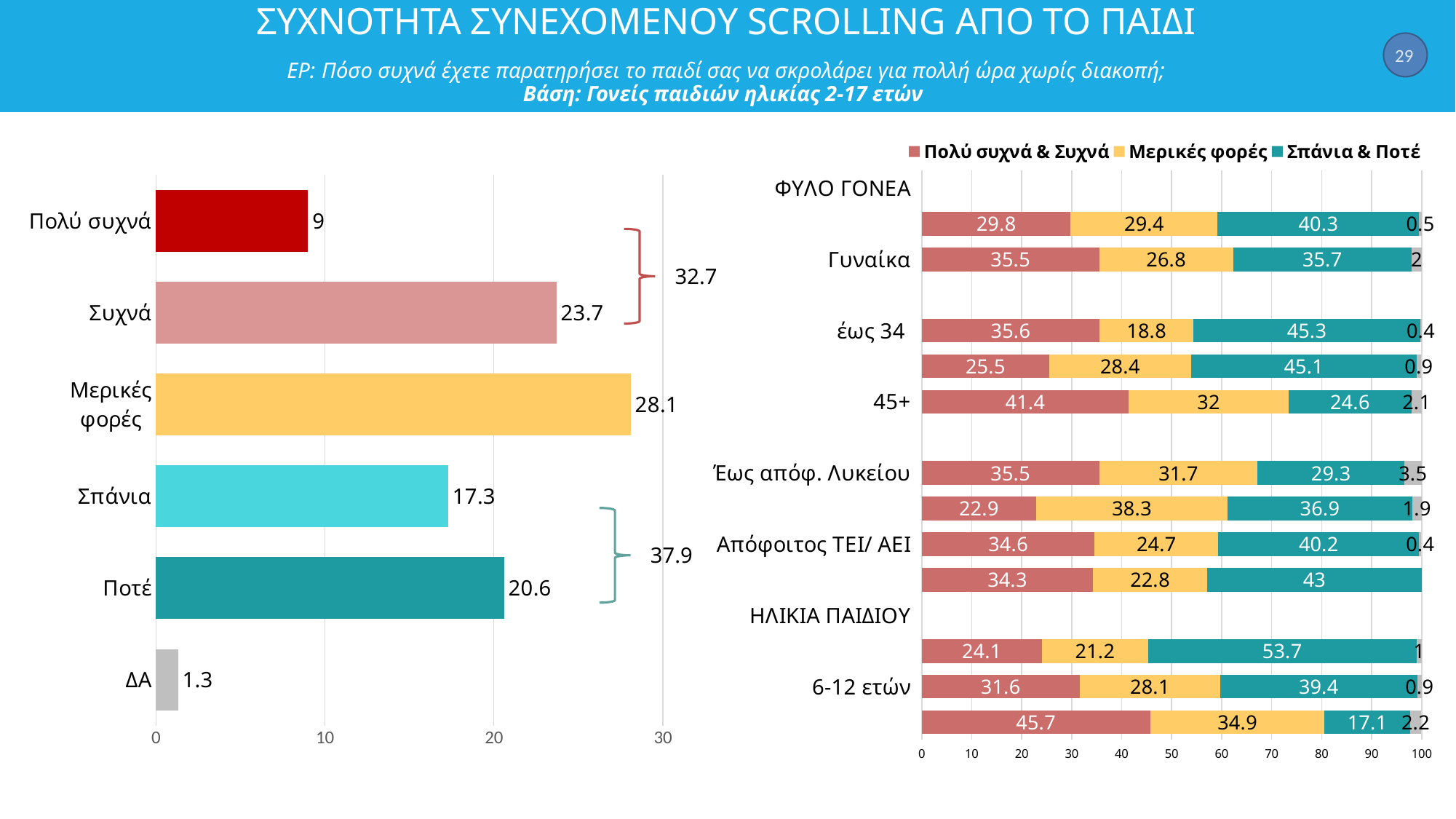
In the left bar chart, what is the value for Ποτέ? 20.6 In the right stacked bar chart, what is the Σπάνια & Ποτέ value for 45+? 24.6 In the left bar chart, which category has the highest value? Μερικές φορές In the left bar chart, which is larger, Σπάνια or Ποτέ? Ποτέ In the left bar chart, which category has the lowest value? ΔΑ In the left bar chart, what is the difference between Συχνά and Πολύ συχνά? 14.7 What kind of chart is the chart on the left? bar chart In the right stacked bar chart, what is the Πολύ συχνά & Συχνά value for Γυναίκα? 35.5 In the left bar chart, how many categories are shown? 6 In the right stacked bar chart, what is the Μερικές φορές value for 6-12 ετών? 28.1 How many series does the legend of the right stacked bar chart list? 3 In the left bar chart, what is the value for Μερικές φορές? 28.1